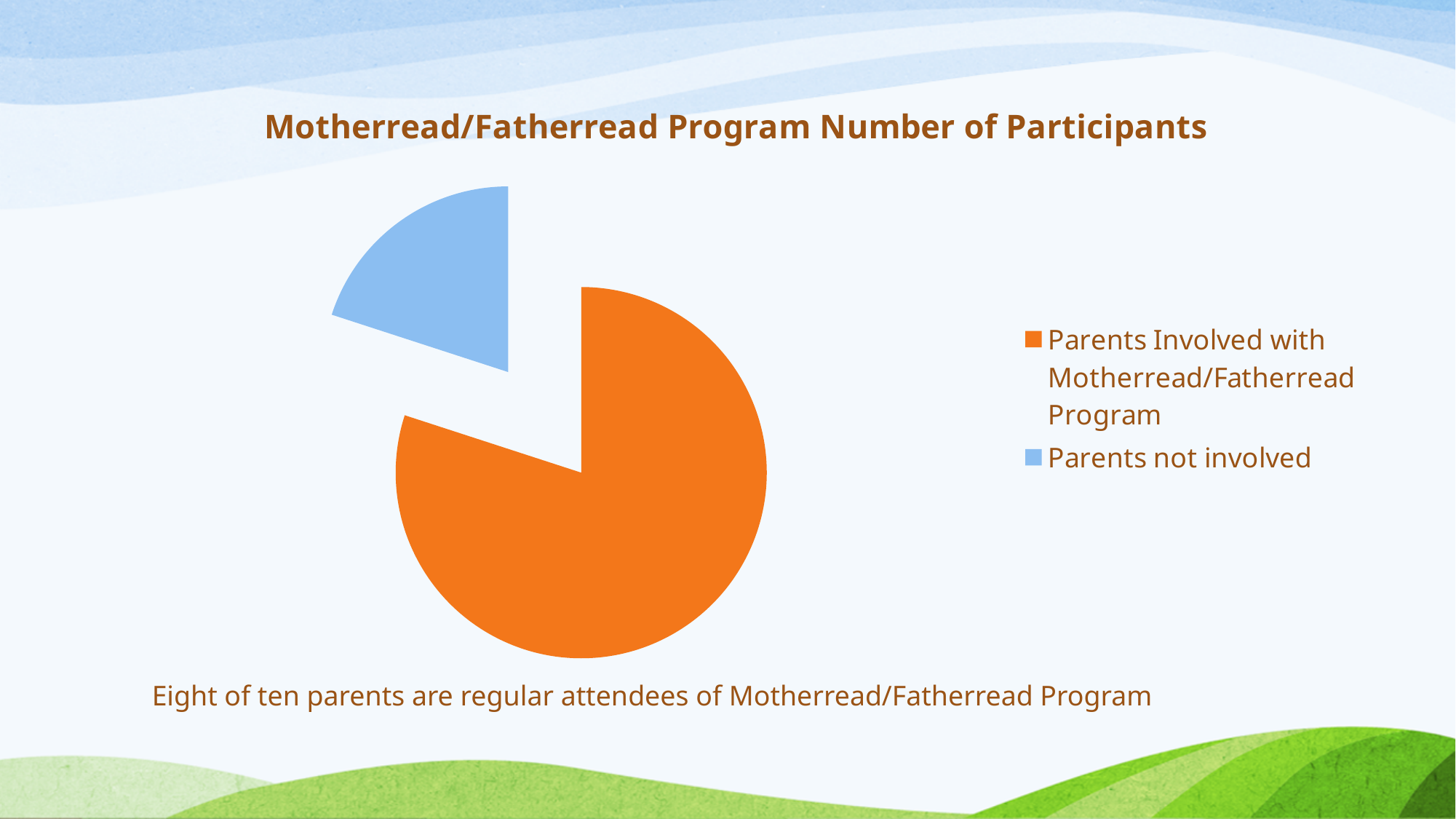
What colour is the slice for Parents not involved? blue Which slice is larger: Parents Involved with Motherread/Fatherread Program or Parents not involved? Parents Involved with Motherread/Fatherread Program Which category has the smallest slice of the pie chart? Parents not involved What kind of chart is shown on the slide? pie chart How many slices does the pie chart have? 2 What is the title of the pie chart? Motherread/Fatherread Program Number of Participants How many entries does the legend of the pie chart list? 2 Which category has the largest slice of the pie chart? Parents Involved with Motherread/Fatherread Program